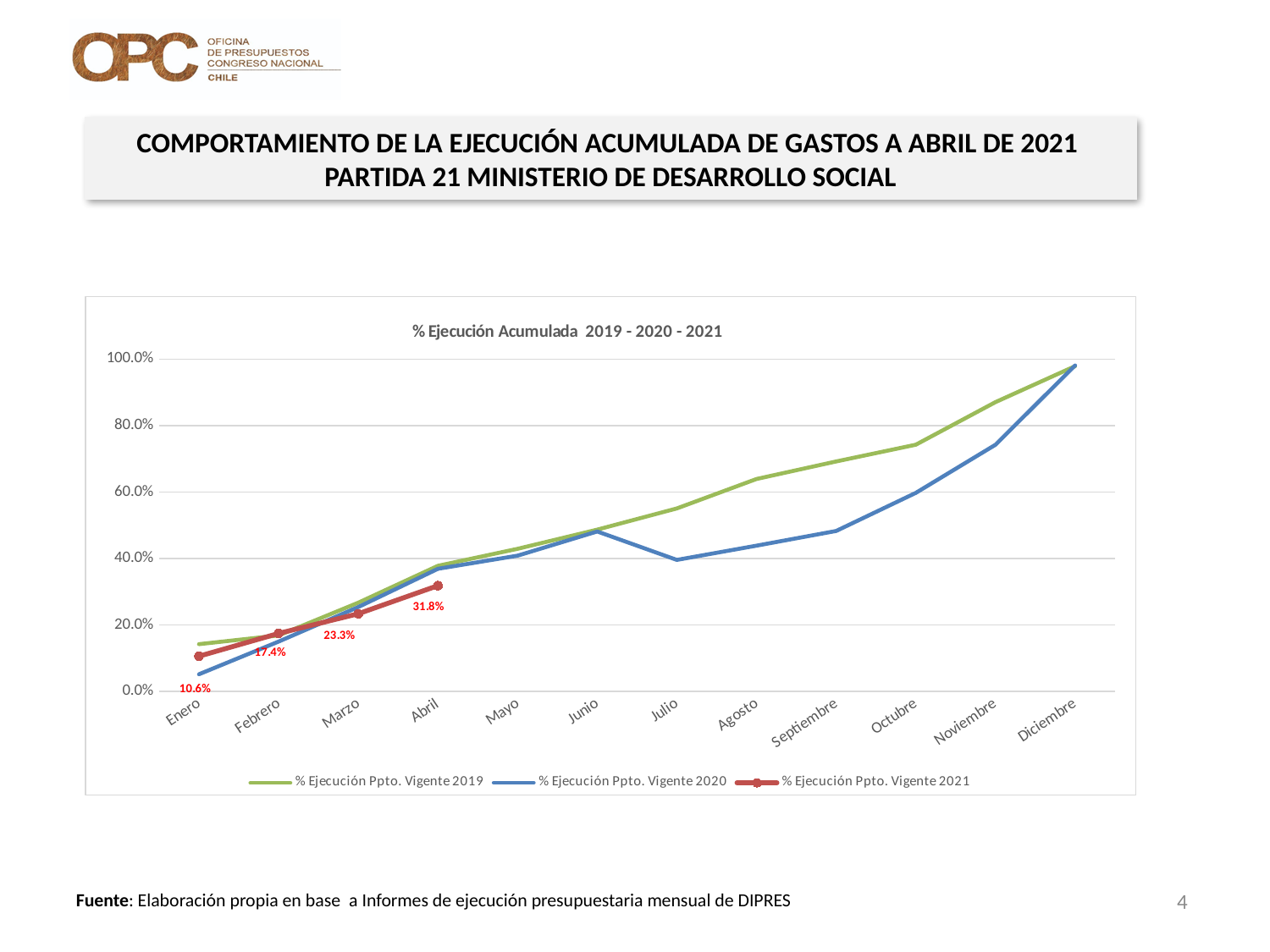
In the % Ejecución Ppto. Vigente 2021 series, which month has the highest value? Abril What is the value for Enero in the % Ejecución Ppto. Vigente 2021 series? 10.6% What is the value for Marzo in the % Ejecución Ppto. Vigente 2021 series? 23.3% Is the value for Octubre in the % Ejecución Ppto. Vigente 2019 series greater or less than 60.0%? greater What is the difference between the Marzo and Febrero values of the % Ejecución Ppto. Vigente 2021 series? 5.9 percentage points Is the value for Enero in the % Ejecución Ppto. Vigente 2020 series greater or less than 20.0%? less What is the value for Abril in the % Ejecución Ppto. Vigente 2021 series? 31.8% How many series does the chart legend list? 3 What is the difference between the Abril and Enero values of the % Ejecución Ppto. Vigente 2021 series? 21.2 percentage points In Agosto, which series is higher: % Ejecución Ppto. Vigente 2019 or % Ejecución Ppto. Vigente 2020? % Ejecución Ppto. Vigente 2019 How many months are shown on the x axis of the chart? 12 What type of chart is shown on the slide? Line chart